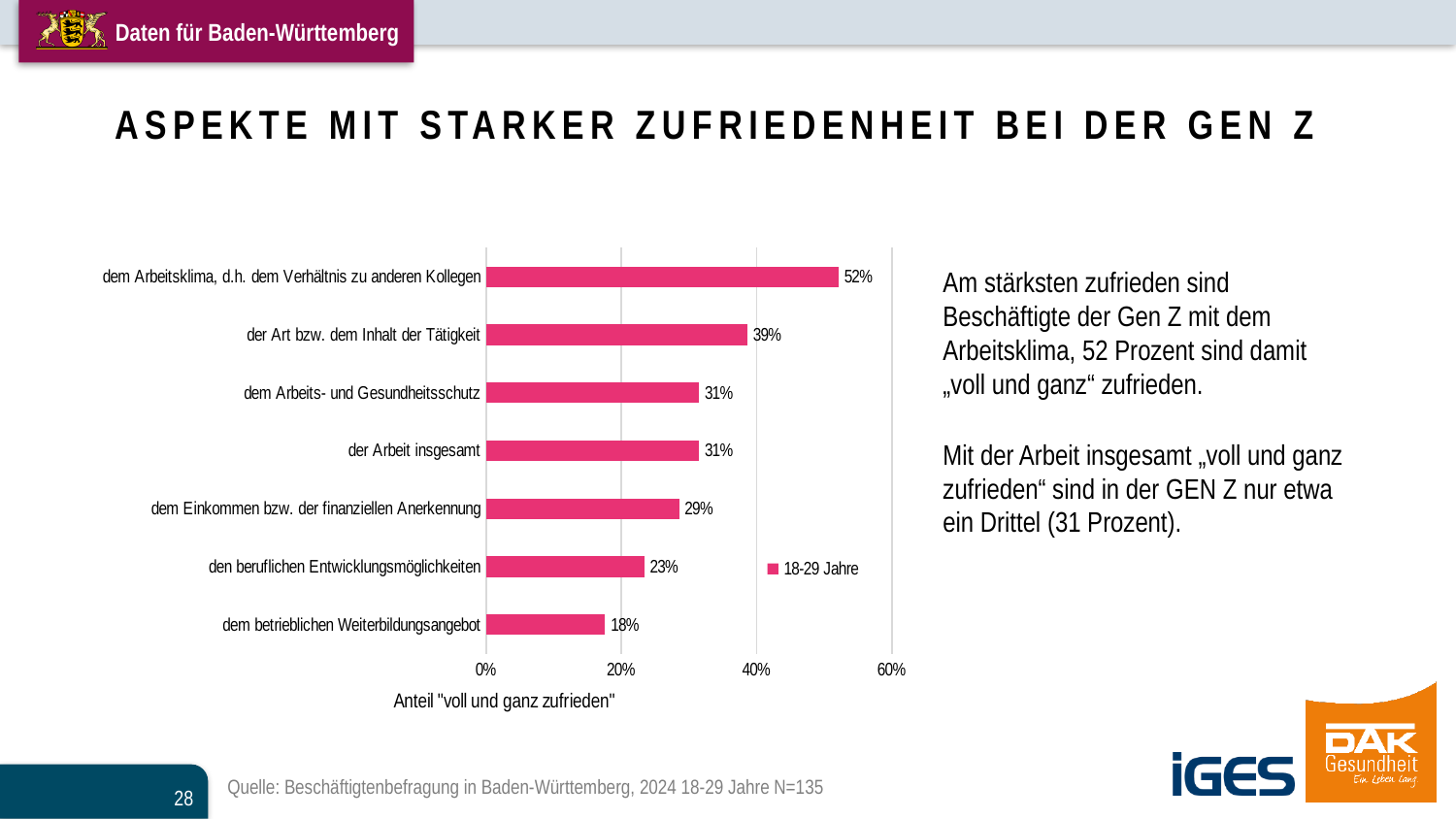
Which category has the highest value? dem Arbeitsklima, d.h. dem Verhältnis zu anderen Kollegen What series name is shown in the chart legend? 18-29 Jahre What is the value for "dem Arbeitsklima, d.h. dem Verhältnis zu anderen Kollegen"? 52% What is the difference between the values for "der Art bzw. dem Inhalt der Tätigkeit" and "den beruflichen Entwicklungsmöglichkeiten"? 16% Which is larger: the value for "der Art bzw. dem Inhalt der Tätigkeit" or for "der Arbeit insgesamt"? der Art bzw. dem Inhalt der Tätigkeit What kind of chart is shown on the slide? bar chart Which category has the lowest value? dem betrieblichen Weiterbildungsangebot How many series does the legend list? 1 What is the value for "dem Einkommen bzw. der finanziellen Anerkennung"? 29% How many categories are shown in the chart? 7 Is the value for "dem Arbeits- und Gesundheitsschutz" greater or less than 40%? less What is the value for "dem betrieblichen Weiterbildungsangebot"? 18%